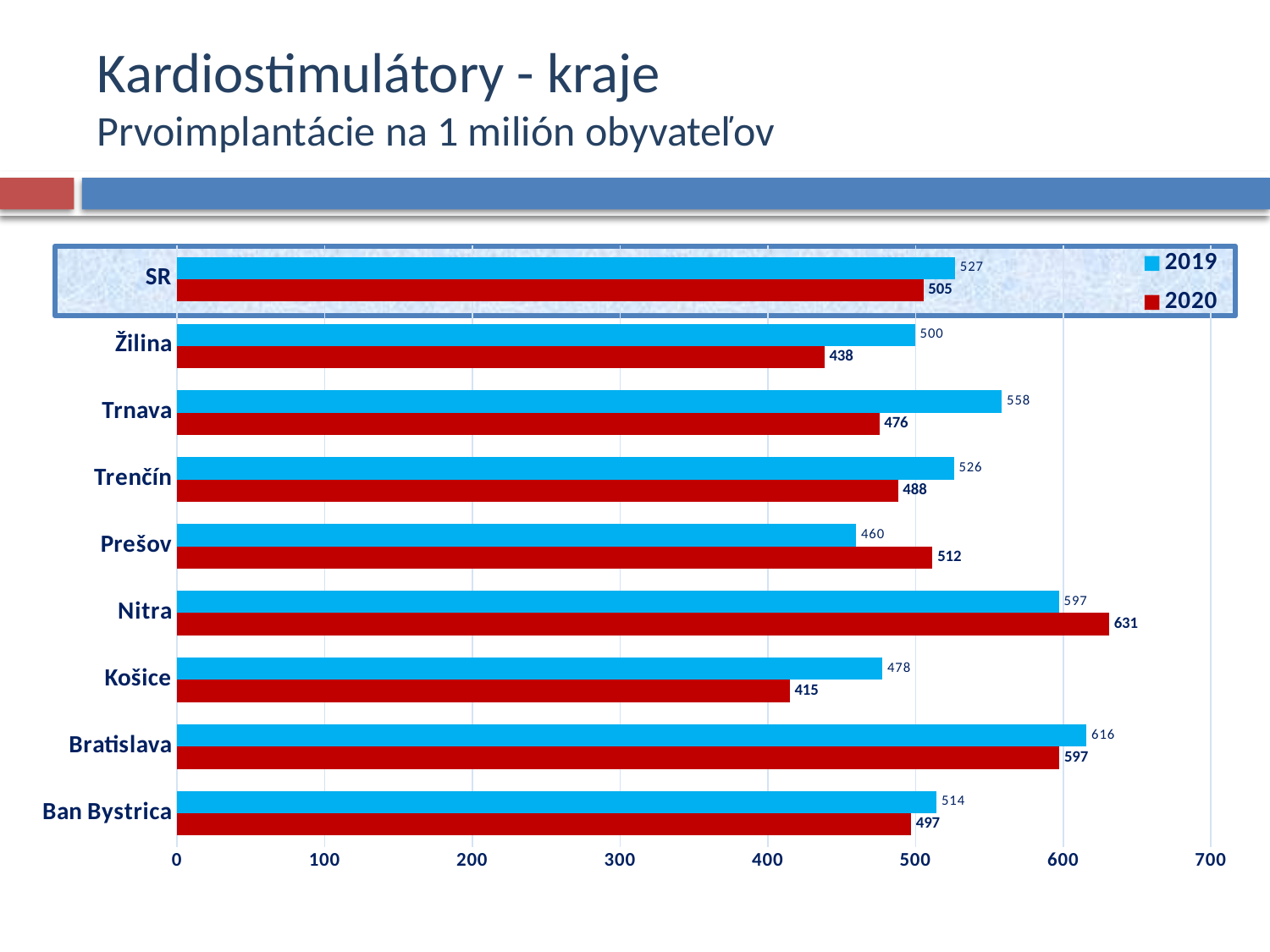
Is the 2020 value for Žilina greater or less than 500? less What is the 2019 value for Prešov? 460 Which region has the highest 2019 value? Bratislava Which colour represents the 2020 series? red Which region has the lowest 2020 value? Košice What is the 2020 value for SR? 505 What is the 2020 value for Nitra? 631 What kind of chart is shown? bar chart What is the difference between the 2019 and 2020 values for Trnava? 82 Which is larger for Prešov, the 2019 value or the 2020 value? 2020 How many series does the legend list? 2 How many categories are shown on the y axis? 9